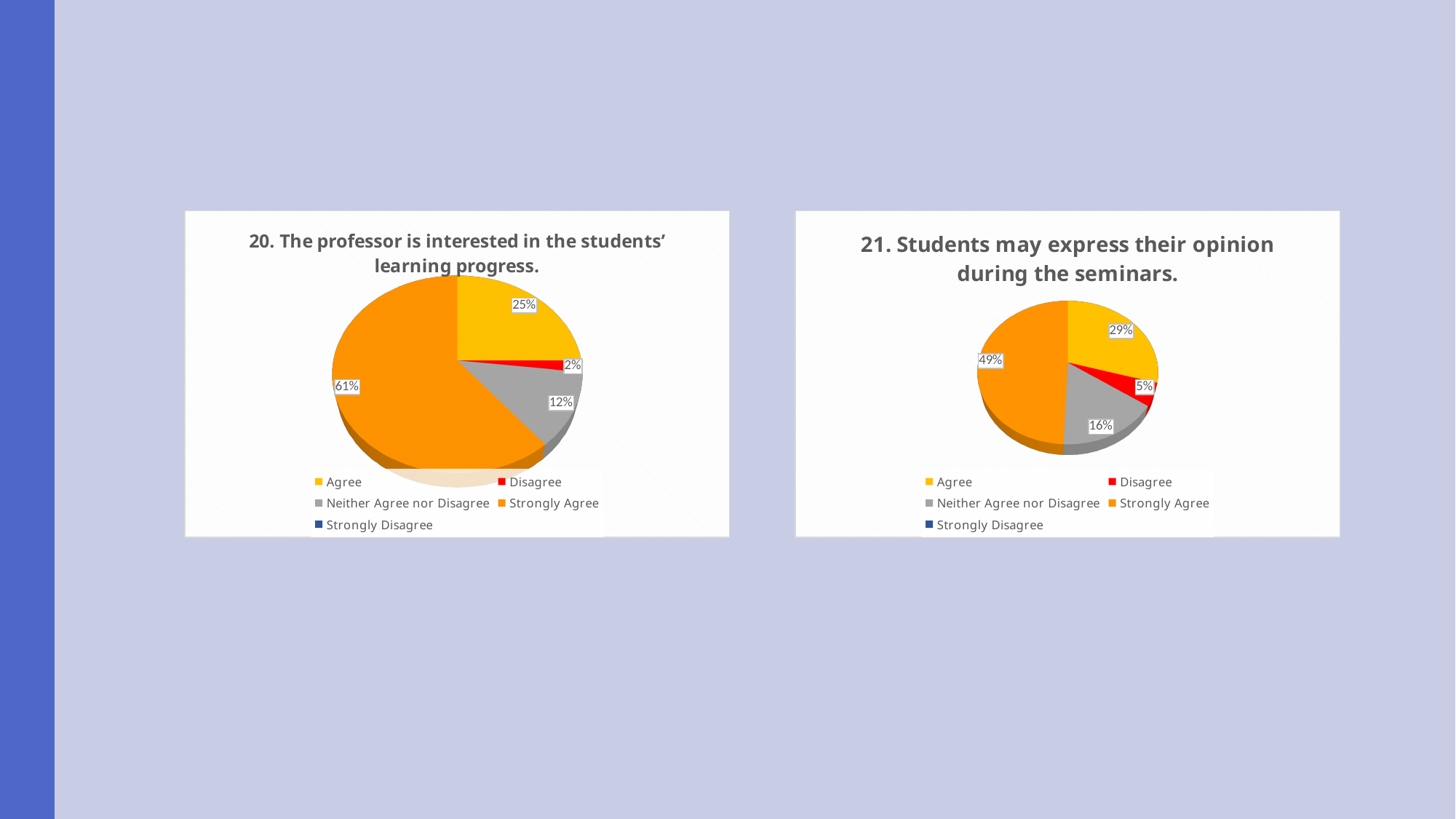
In the right chart (question 21), what is the difference between the Strongly Agree share and the Neither Agree nor Disagree share? 33% What is the title of the left chart? 20. The professor is interested in the students' learning progress. In the right chart (question 21), what share of respondents chose Agree? 29% In the right chart (question 21), which labelled response category has the smallest share? Disagree In the left chart (question 20), what share of respondents chose Neither Agree nor Disagree? 12% How many entries does the legend of the right chart (question 21) list? 5 In the left chart (question 20), which response category has the largest share? Strongly Agree Which chart has the larger Strongly Agree share, the left chart (question 20) or the right chart (question 21)? The left chart (question 20) In the left chart (question 20), what is the difference between the Strongly Agree share and the Agree share? 36% In the right chart (question 21), what share of respondents chose Disagree? 5% In the left chart (question 20), what share of respondents chose Strongly Agree? 61% What type of chart is used on this slide? Pie chart